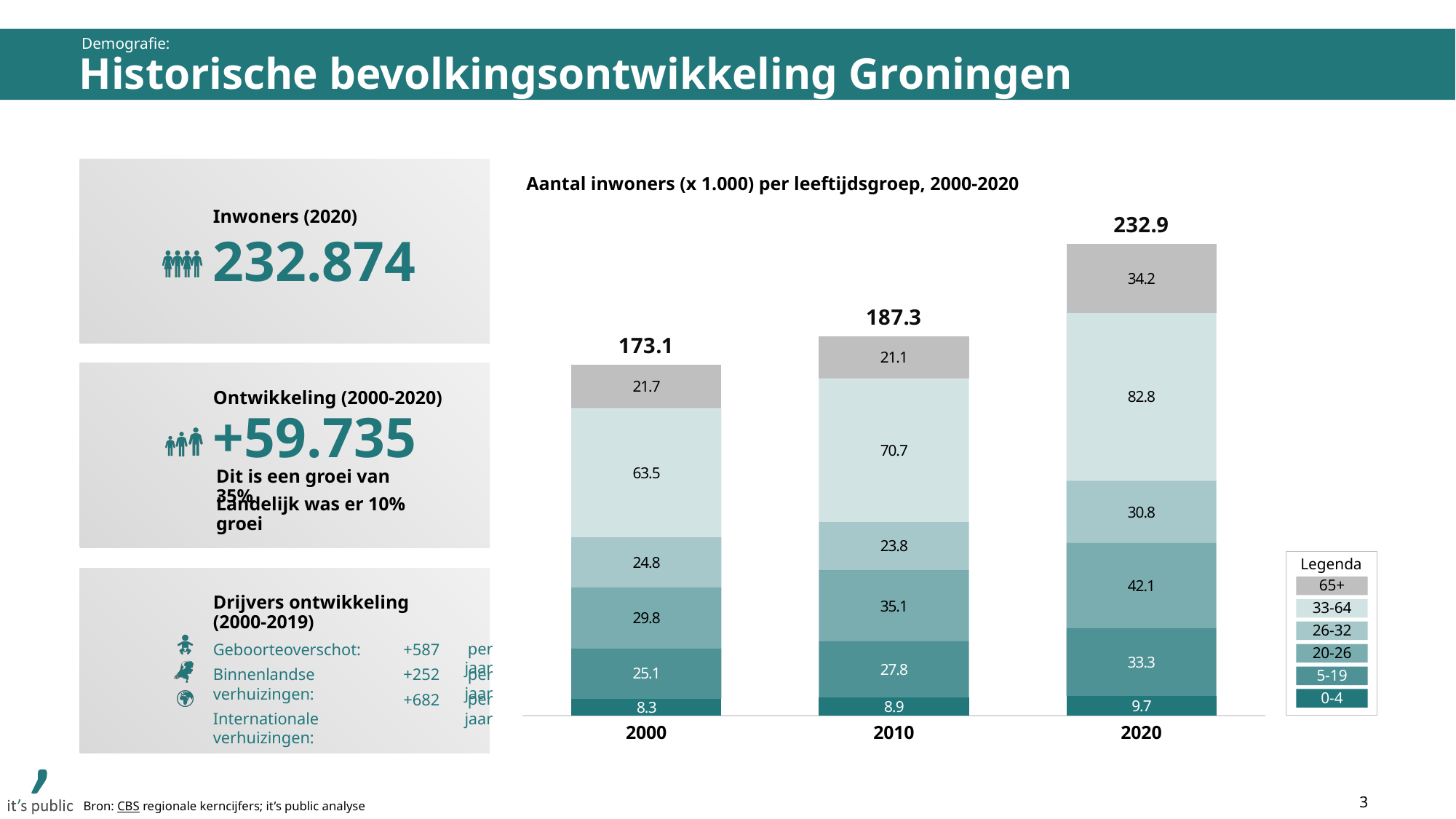
What kind of chart is shown on the slide? Stacked bar chart Which year has the highest total number of inhabitants? 2020 Which is larger: the 20-26 value in 2020 or the 20-26 value in 2000? 2020 Do the total values rise or fall from 2000 to 2020? Rise What is the value for the 0-4 age group in 2020? 9.7 How many years are shown on the x axis? 3 What is the total number of inhabitants (x 1.000) shown for 2020? 232.9 How many age groups does the legend list? 6 Which year has the lowest total number of inhabitants? 2000 What is the value for the 65+ age group in 2000? 21.7 What is the difference between the 65+ values for 2020 and 2010? 13.1 What is the value for the 33-64 age group in 2010? 70.7